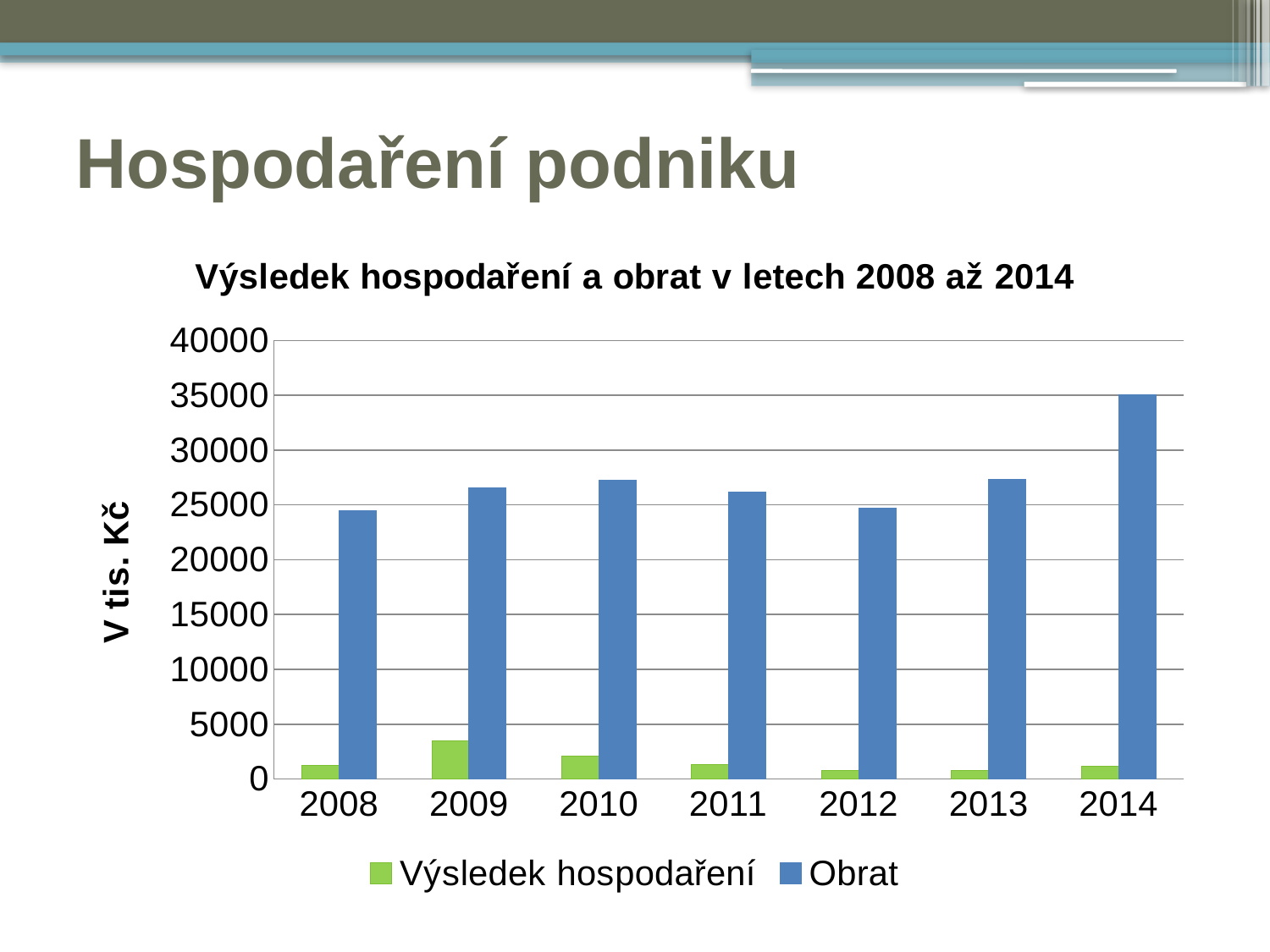
How many years are shown on the x axis? 7 What kind of chart is shown on the slide? bar chart What is the title of the chart? Výsledek hospodaření a obrat v letech 2008 až 2014 Is the Obrat value for 2008 greater or less than 25000? less Which year has the larger Výsledek hospodaření, 2009 or 2012? 2009 Which year has the larger Obrat, 2010 or 2012? 2010 Is the Výsledek hospodaření value for 2009 greater or less than 5000? less What is the label on the vertical axis? V tis. Kč How many series does the legend list? 2 In which year is Výsledek hospodaření highest? 2009 In which year is Obrat highest? 2014 Is the Obrat value for 2014 greater or less than 30000? greater